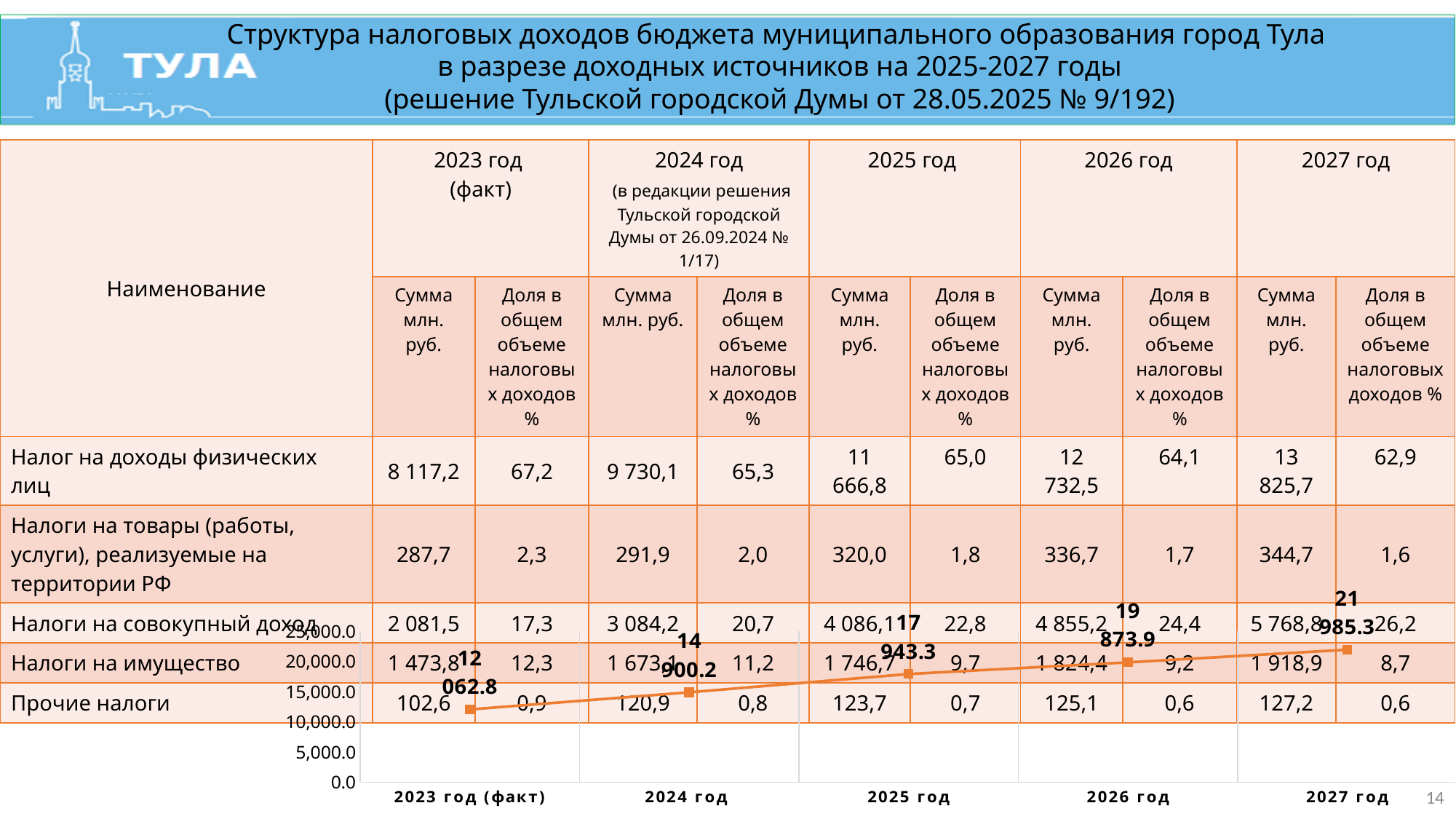
In the line chart, what is the value for 2026 год? 19 873.9 How many data points does the line chart plot? 5 Is the value for 2023 год (факт) in the line chart greater or less than 15,000.0? less What kind of chart is shown at the bottom of the slide? line chart Which year has the highest value in the line chart? 2027 год In the line chart, which is larger: the value for 2025 год or the value for 2024 год? 2025 год In the line chart, what is the value for 2025 год? 17 943.3 Do the values in the line chart rise or fall from 2023 год (факт) to 2027 год? rise In the line chart, what is the value for 2027 год? 21 985.3 In the line chart, what is the difference between the values for 2024 год and 2023 год (факт)? 2 837.4 In the line chart, what is the value for 2023 год (факт)? 12 062.8 Which year has the lowest value in the line chart? 2023 год (факт)